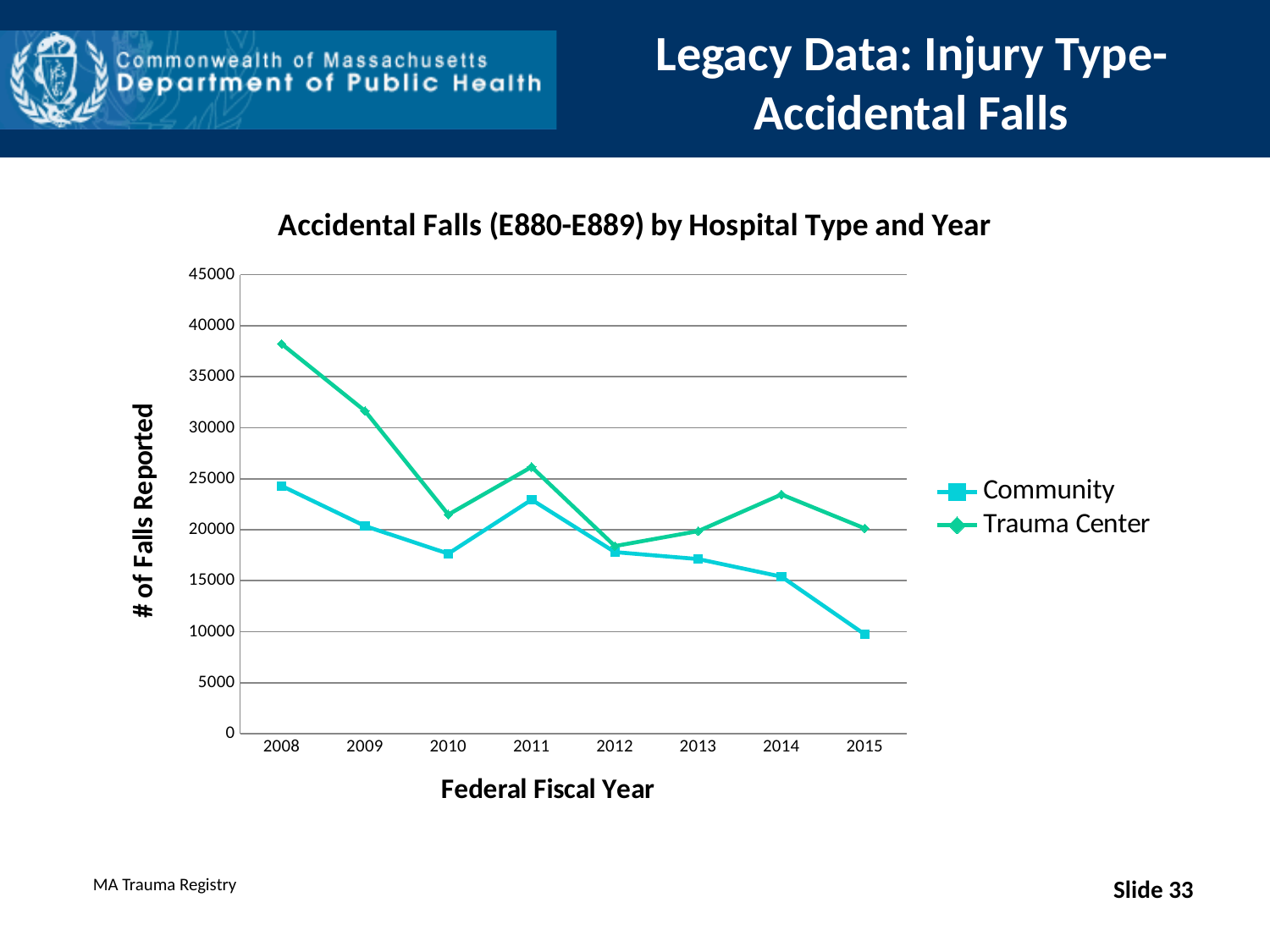
What is the title of the chart? Accidental Falls (E880-E889) by Hospital Type and Year Is the Trauma Center value for 2011 greater or less than 25000? greater In which year is the Trauma Center series at its highest? 2008 What kind of chart is shown on the slide? line chart Is the Trauma Center value for 2008 greater or less than 35000? greater In which year is the Community series at its lowest? 2015 How many years are plotted along the x axis? 8 How many series does the legend list? 2 Does the Community series generally rise or fall from 2008 to 2015? fall Which series has the larger value in 2009, Community or Trauma Center? Trauma Center